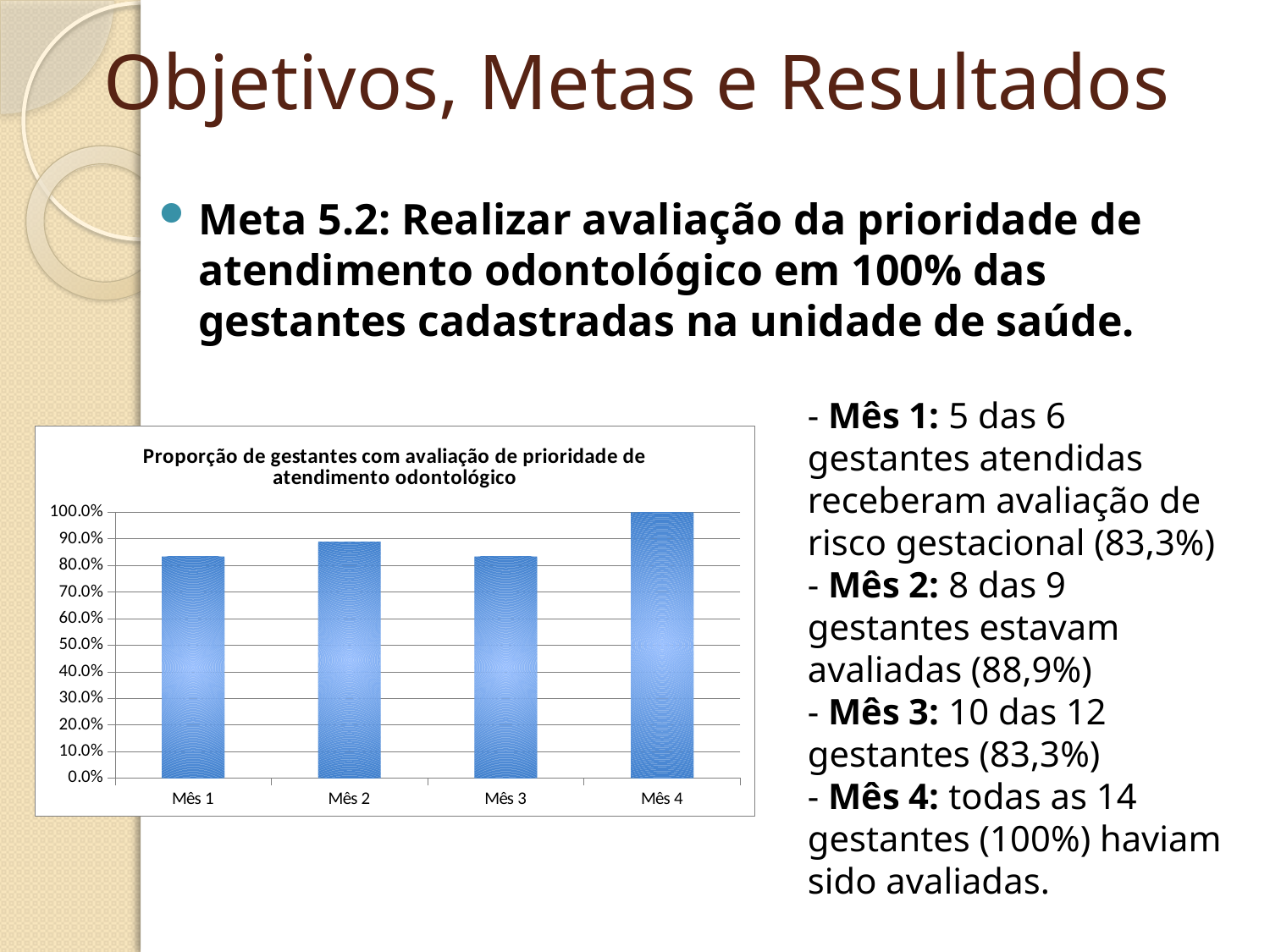
What is the title of the chart? Proporção de gestantes com avaliação de prioridade de atendimento odontológico Is the value for Mês 2 greater or less than 80.0%? greater Which month has the highest value in the chart? Mês 4 How many categories (months) are shown on the x axis of the chart? 4 What is the value for Mês 4 in the chart? 100.0% Is the value for Mês 1 greater or less than 80.0%? greater What type of chart is shown on the slide? Bar chart What is the highest value shown on the y axis of the chart? 100.0% Is the value for Mês 1 greater or less than 90.0%? less Which is larger, the value for Mês 2 or the value for Mês 1? Mês 2 Which is larger, the value for Mês 4 or the value for Mês 3? Mês 4